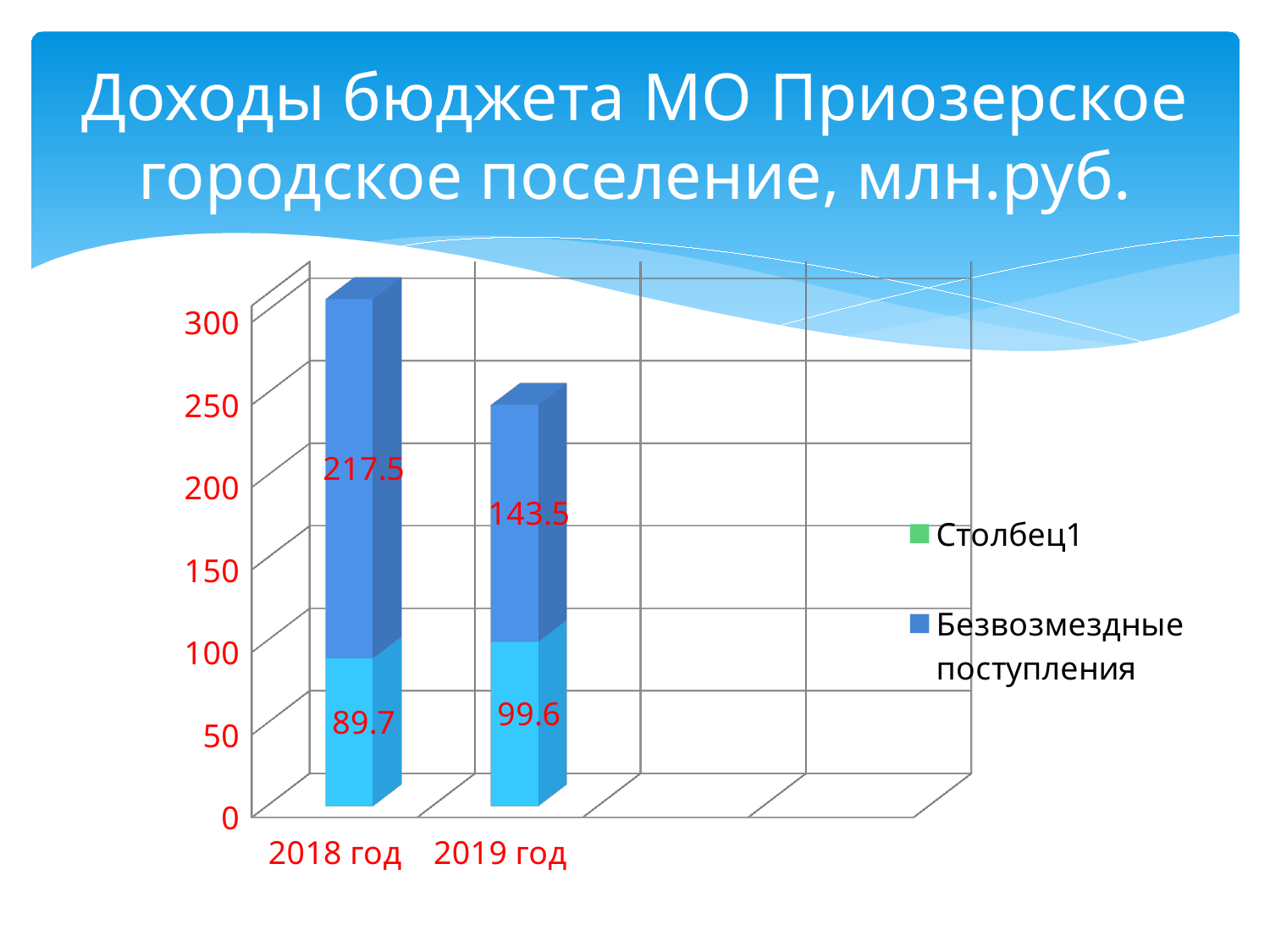
What kind of chart is shown on the slide? Stacked bar chart What value is printed on the lower (light blue) segment of the 2018 год bar? 89.7 What is the total of the stacked bar for 2018 год? 307.2 What value is printed on the lower (light blue) segment of the 2019 год bar? 99.6 Which year has the larger value for Безвозмездные поступления, 2018 год or 2019 год? 2018 год What is the value of Безвозмездные поступления for 2019 год? 143.5 How many categories are shown on the x axis? 2 What is the difference between the lower segment values of the 2019 год and 2018 год bars? 9.9 What is the value of Безвозмездные поступления for 2018 год? 217.5 What is the total of the stacked bar for 2019 год? 243.1 By how much does Безвозмездные поступления for 2018 год exceed that for 2019 год? 74 How many series does the legend list? 2